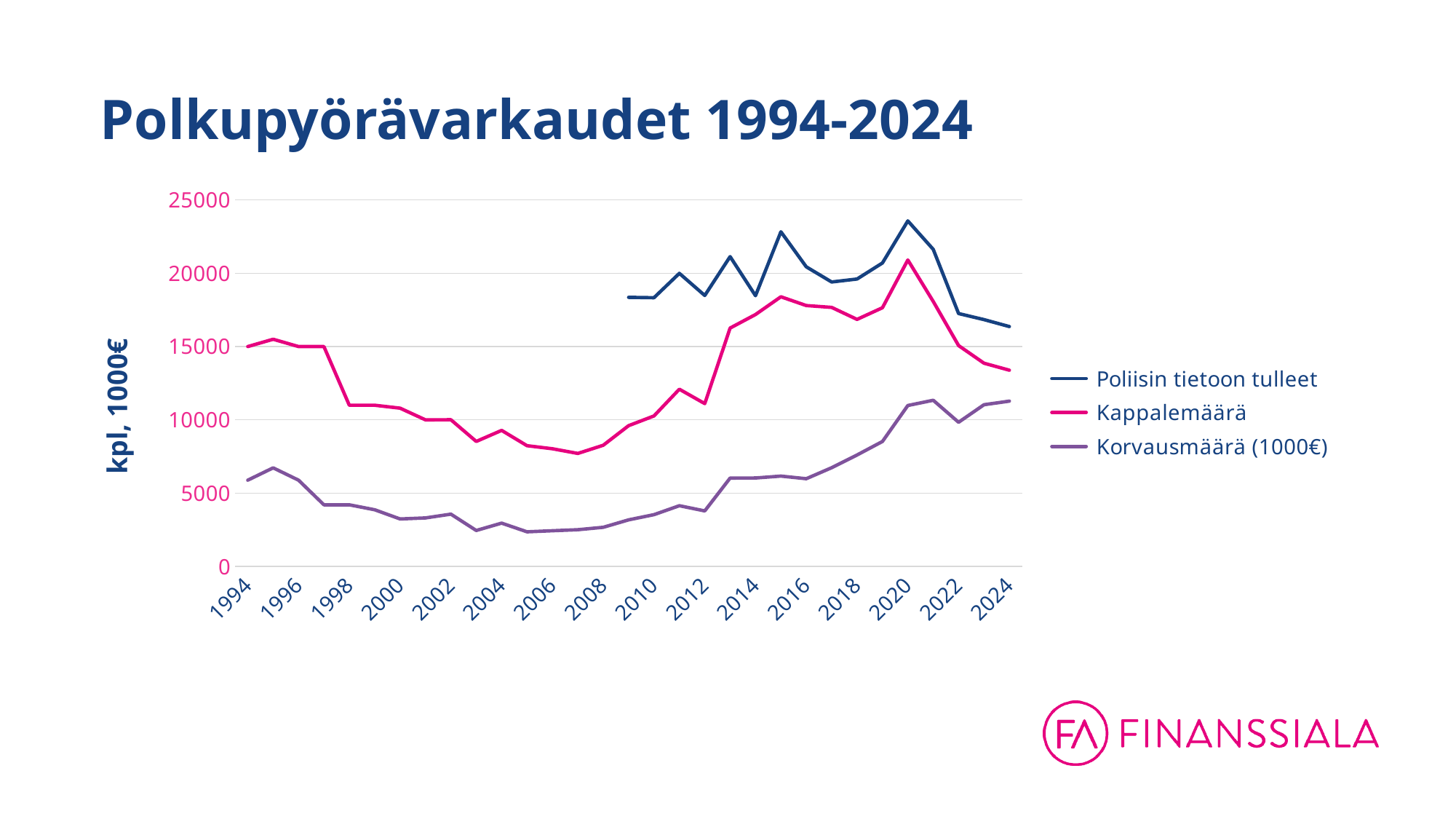
Does the Korvausmäärä (1000€) series generally rise or fall between 2006 and 2022? rise In which year does the Poliisin tietoon tulleet series reach its highest value? 2020 How many series does the legend list? 3 In 2024, which series has the higher value, Poliisin tietoon tulleet or Kappalemäärä? Poliisin tietoon tulleet Is the value for Korvausmäärä (1000€) in 2024 greater or less than 10000? greater Is the value for Poliisin tietoon tulleet in 2021 greater or less than 20000? greater What is the title of the chart? Polkupyörävarkaudet 1994-2024 What is the label on the vertical axis? kpl, 1000€ Is the value for Kappalemäärä in 2024 greater or less than 15000? less In which year does the Kappalemäärä series reach its highest value? 2020 Does the Kappalemäärä series generally rise or fall between 1994 and 2007? fall What kind of chart is shown on the slide? line chart